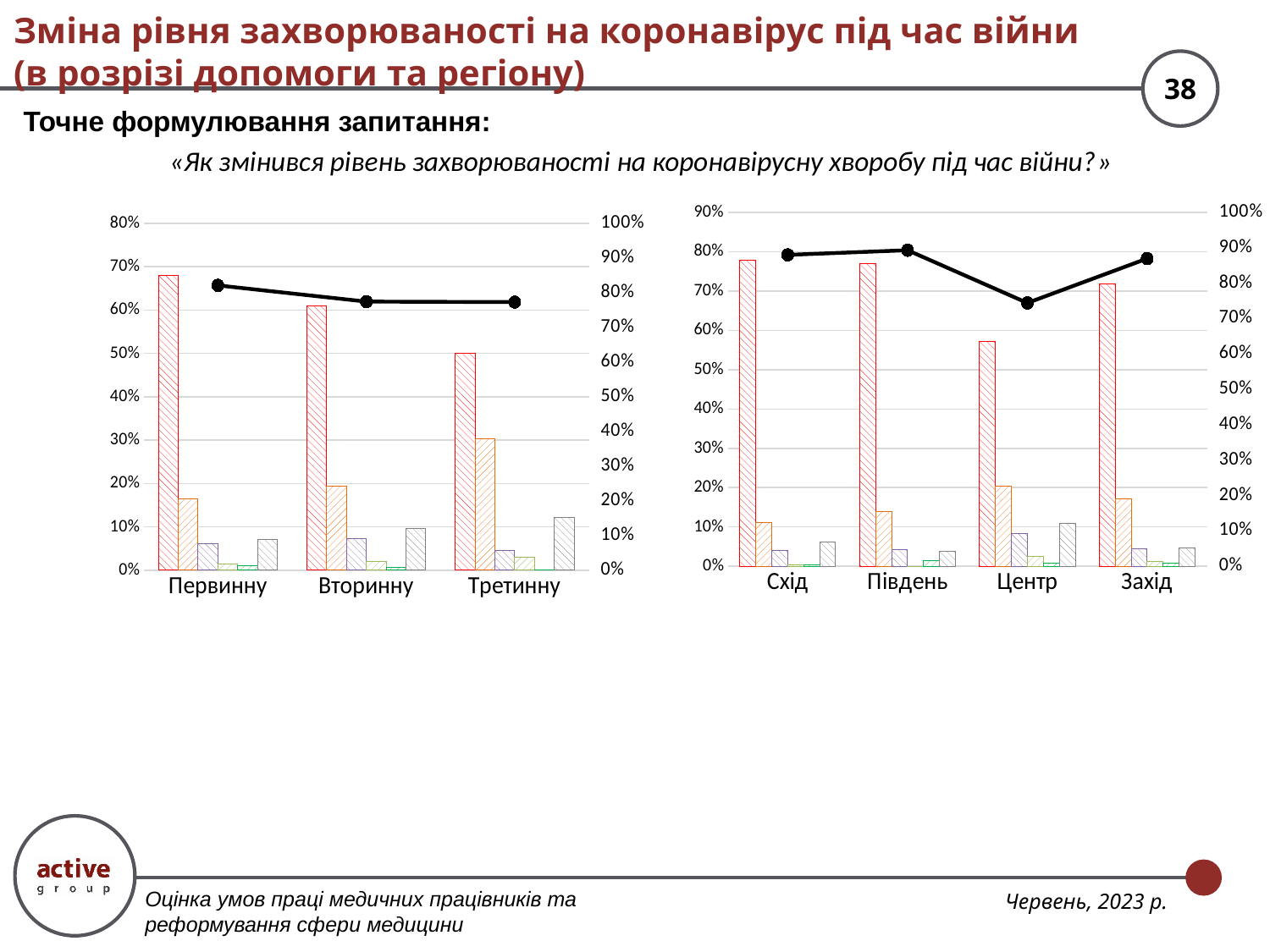
On the left chart, do the red hatched bars rise or fall from Первинну to Третинну? fall On the right chart, is the line point for Центр greater or less than 80% on the right-hand axis? less On the right chart, how many categories are shown on the x axis? 4 On the left chart, which category has the tallest orange hatched bar? Третинну What kind of chart is the left chart? Bar chart with a line On the left chart, is the line point for Первинну greater or less than 70% on the right-hand axis? greater On the right chart, which category has the shortest red hatched bar? Центр On the left chart, how many categories are shown on the x axis? 3 On the left chart, is the red hatched bar for Третинну greater or less than 40%? greater On the left chart, which category has the tallest red hatched bar? Первинну On the right chart, which category has the lowest point on the black line? Центр